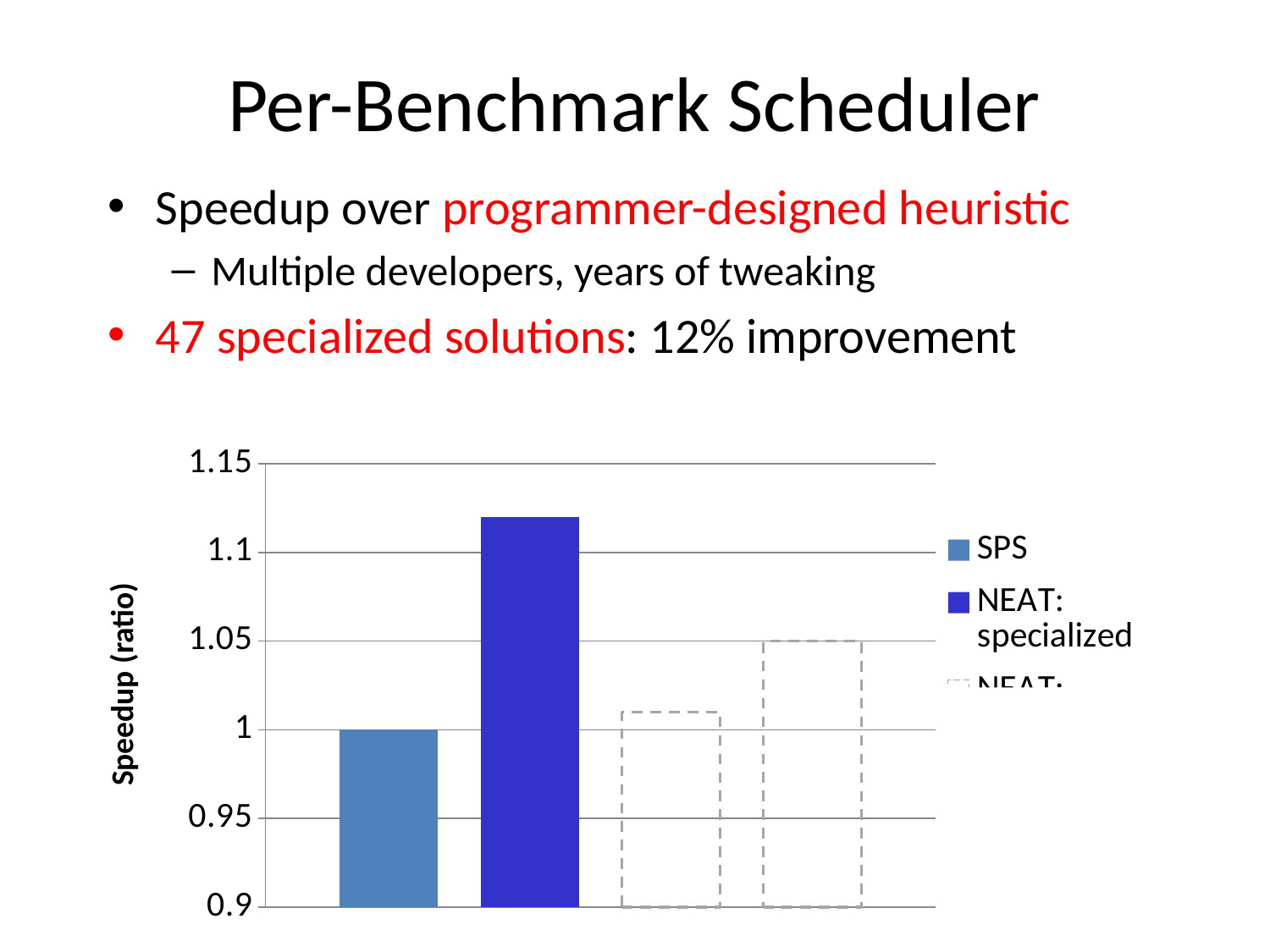
What kind of chart is shown on the slide? bar chart Which bar is the highest in the chart? NEAT: specialized Is the value for NEAT: specialized greater or less than 1.05? greater Which is larger, the value for SPS or the value for NEAT: specialized? NEAT: specialized How many bars are plotted in the chart? 4 What is the title of the y axis? Speedup (ratio) What is the highest value shown on the y axis? 1.15 Is the value for SPS greater or less than 1.05? less Is the value for NEAT: specialized greater or less than 1.1? greater What is the speedup value for SPS? 1